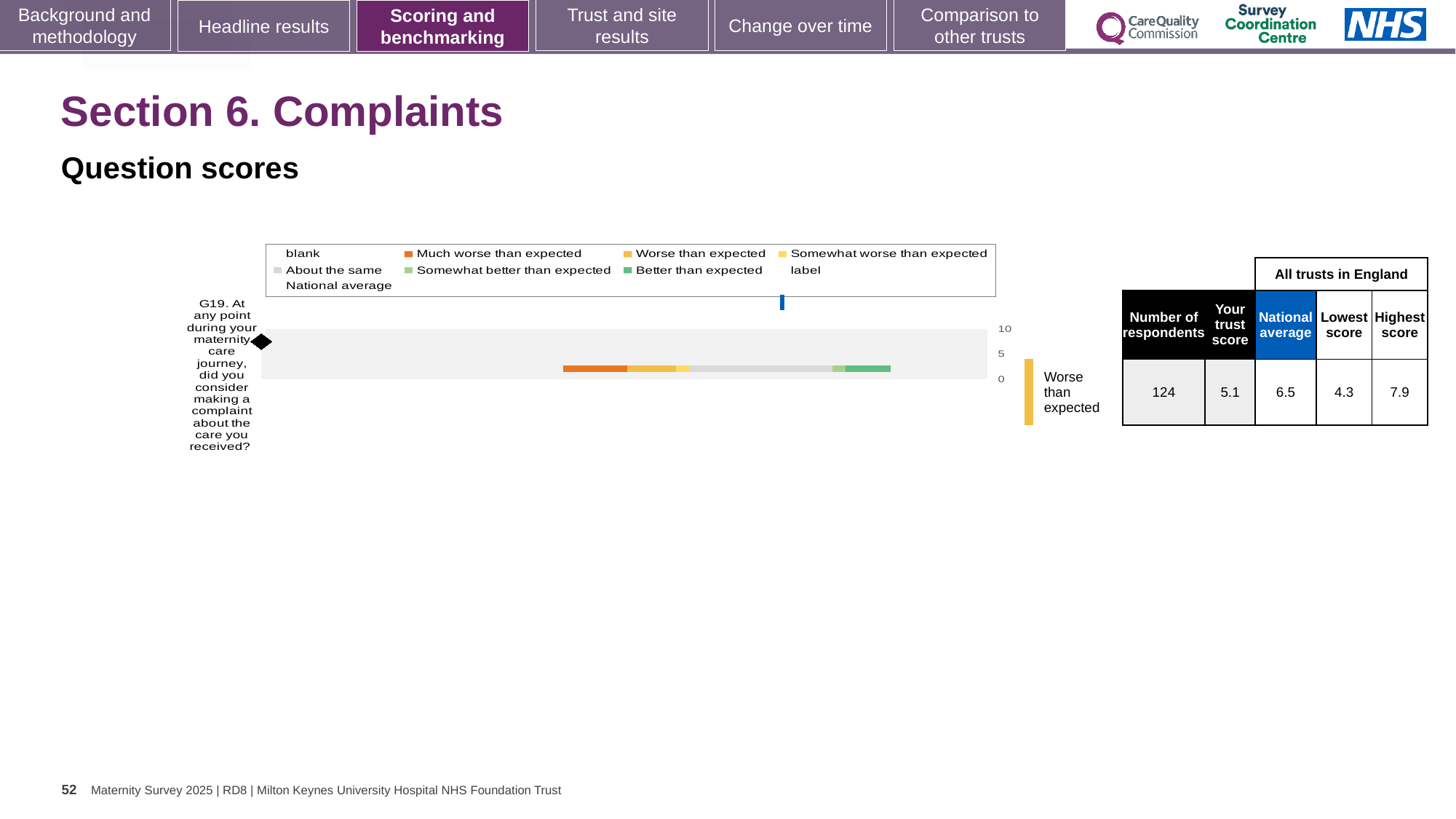
What is the highest tick value shown on the chart's axis? 10 What benchmark rating is shown to the right of the chart for question G19? Worse than expected What kind of chart is shown on the slide? bar chart In the table beside the chart, what is the trust score for G19? 5.1 Is the trust score for G19 larger or smaller than the national average? smaller Which question number is plotted in the chart? G19 What is the difference between the national average and the trust score for G19? 1.4 In the table beside the chart, what is the number of respondents for G19? 124 How many survey questions (categories) are plotted in the chart? 1 In the table beside the chart, what is the highest score among all trusts in England for G19? 7.9 In the table beside the chart, what is the lowest score among all trusts in England for G19? 4.3 In the table beside the chart, what is the national average score for G19? 6.5